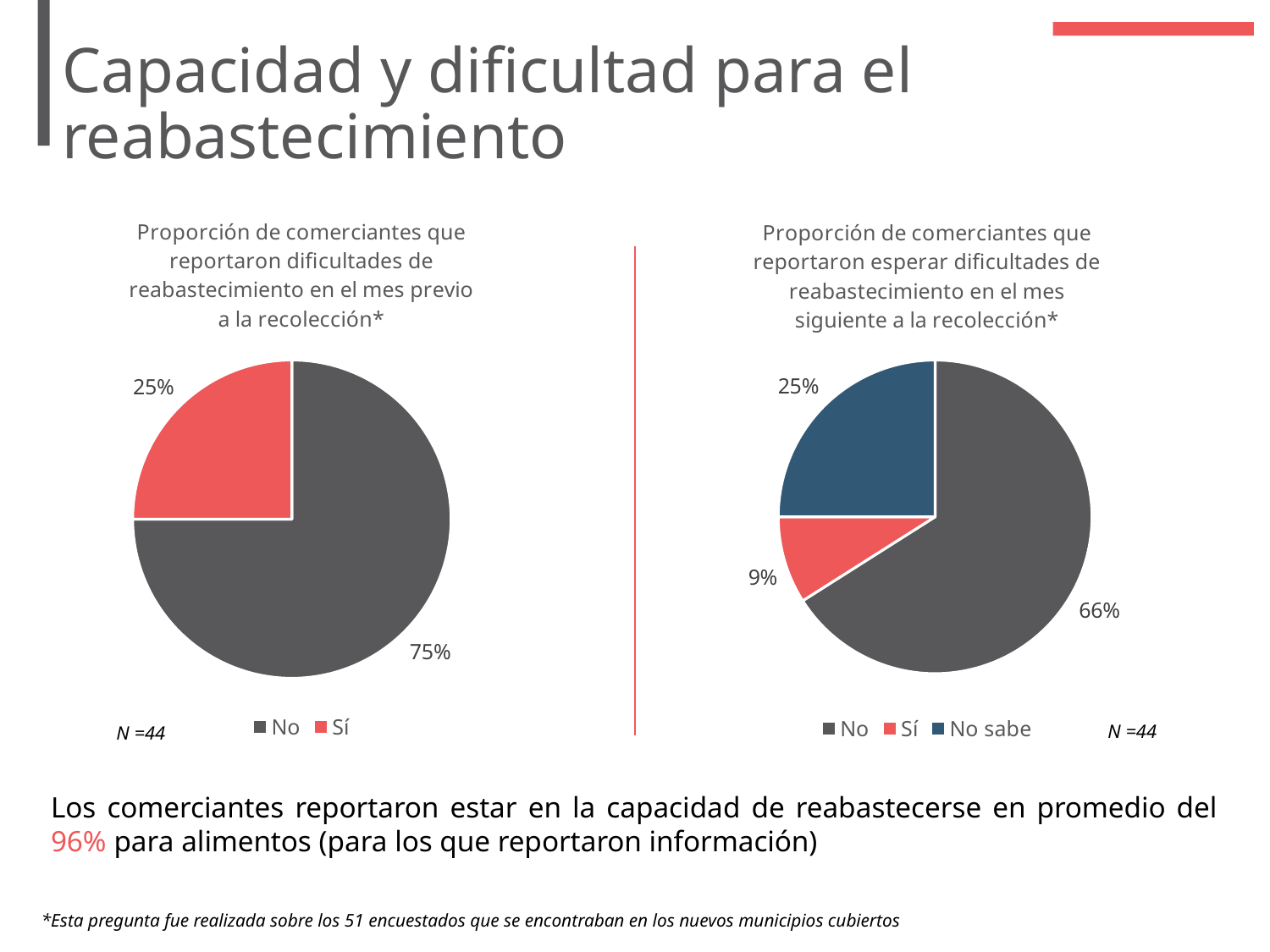
In the right pie chart (expected difficulties in the following month), which response has the smallest share? Sí What type of chart is used on the left side of the slide? Pie chart In the left pie chart (difficulties in the previous month), which response has the largest share? No In the right pie chart (expected difficulties in the following month), what percentage of merchants answered "No sabe"? 25% In the left pie chart (difficulties in the previous month), what is the difference in percentage points between the "No" and "Sí" shares? 50 percentage points What sample size (N) is shown for the left pie chart (difficulties in the previous month)? N =44 In the right pie chart (expected difficulties in the following month), what percentage of merchants answered "Sí"? 9% How many series does the legend of the right pie chart (expected difficulties in the following month) list? 3 In the left pie chart (difficulties in the previous month), what percentage of merchants answered "No"? 75% In the right pie chart (expected difficulties in the following month), which is larger: the "No sabe" share or the "Sí" share? No sabe In the left pie chart (difficulties in the previous month), what percentage of merchants answered "Sí"? 25% In the right pie chart (expected difficulties in the following month), what percentage of merchants answered "No"? 66%